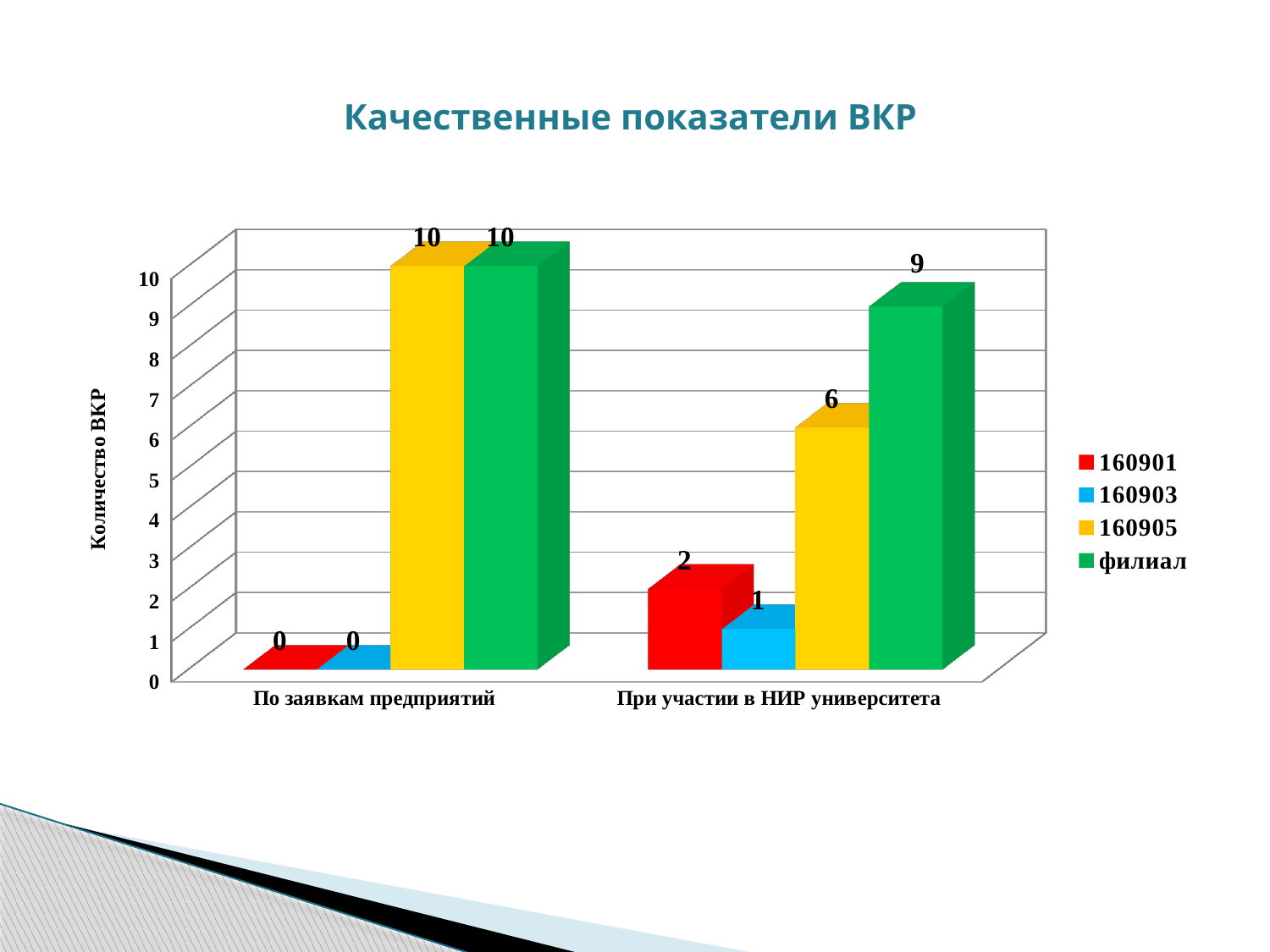
Which is larger: the value for 160901 or 160903 in the category 'При участии в НИР университета'? 160901 What is the title of the slide? Качественные показатели ВКР Which series has the lowest value in the category 'При участии в НИР университета'? 160903 What is the value for 160901 in the category 'При участии в НИР университета'? 2 What is the value for 160903 in the category 'По заявкам предприятий'? 0 What is the difference between the values for филиал and 160905 in the category 'При участии в НИР университета'? 3 How many series does the legend list? 4 What kind of chart is shown on the slide? bar chart Which series has the highest value in the category 'При участии в НИР университета'? филиал How many categories are shown on the x axis? 2 What is the value for филиал in the category 'При участии в НИР университета'? 9 What is the value for 160905 in the category 'По заявкам предприятий'? 10